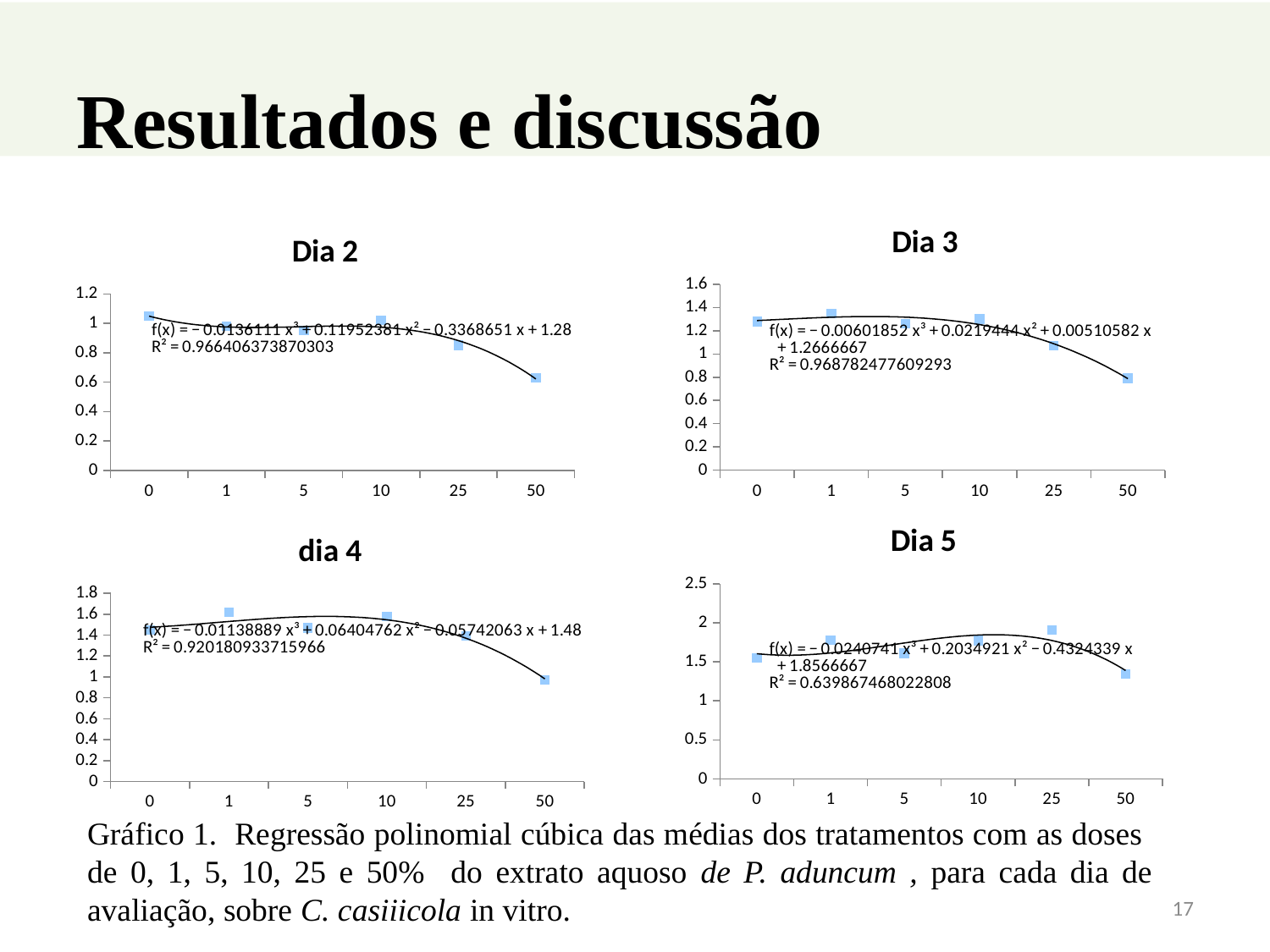
How many data points are plotted on the "Dia 3" chart? 6 On the "Dia 3" chart, is the value for dose 1 greater or less than 1.2? greater On the "Dia 3" chart, which dose has the lowest value? 50 On the "Dia 5" chart, which dose has the highest value? 25 On the "Dia 2" chart, which dose has the lowest value? 50 What R² value is printed on the "Dia 5" chart? 0.639867468022808 On the "Dia 2" chart, is the value for dose 50 greater or less than 0.8? less On the "Dia 2" chart, do the values overall rise or fall from dose 0 to dose 50? fall On the "dia 4" chart, is the value for dose 50 greater or less than 1.2? less What kind of chart is the "Dia 2" chart? scatter chart On the "dia 4" chart, which dose has the lowest value? 50 On the "Dia 5" chart, which is larger, the value for dose 25 or the value for dose 50? dose 25